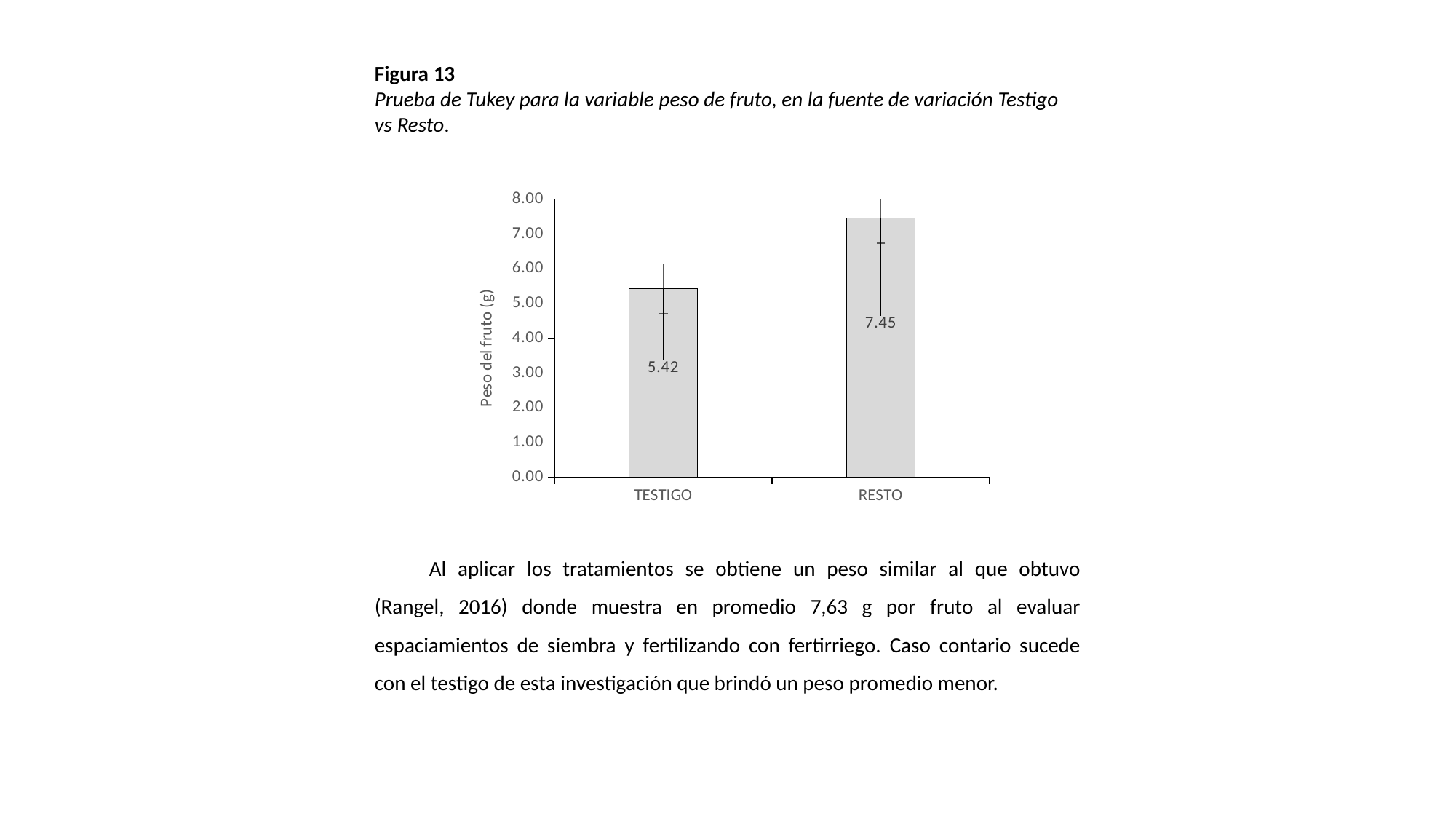
What is the label of the y axis? Peso del fruto (g) What is the figure number given above the chart? Figura 13 Which is larger, the value for TESTIGO or the value for RESTO? RESTO What is the value for TESTIGO? 5.42 What is the value for RESTO? 7.45 Is the value for RESTO greater or less than 7.00? greater What is the difference between the values for RESTO and TESTIGO? 2.03 Which category has the highest value? RESTO Which category has the lowest value? TESTIGO How many categories are shown on the x axis? 2 What kind of chart is shown? bar chart Is the value for TESTIGO greater or less than 6.00? less